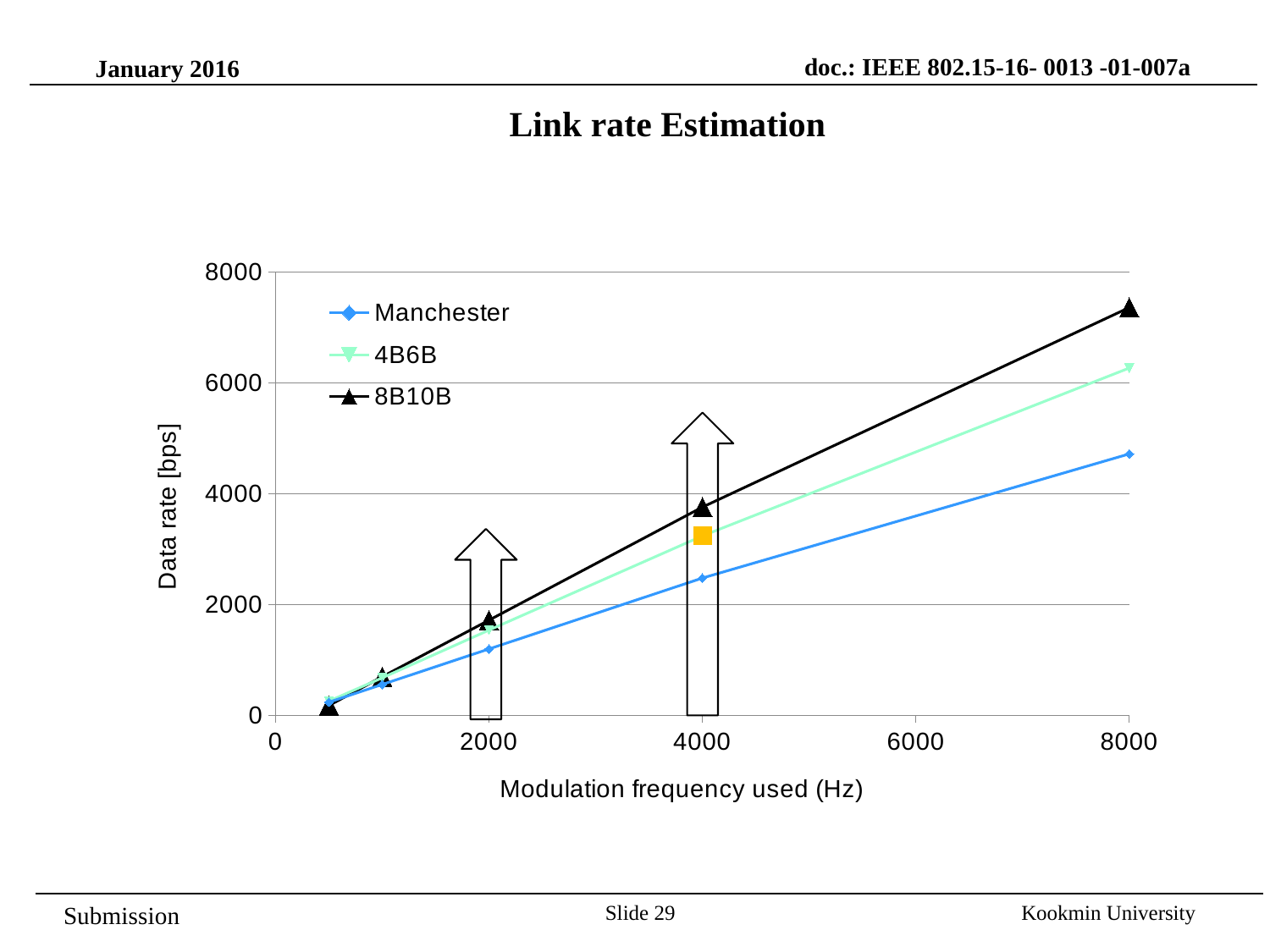
At 4000 Hz, which series has the larger data rate, Manchester or 8B10B? 8B10B Do the data rate values rise or fall as the modulation frequency increases? rise Is the 4B6B data rate at 4000 Hz greater or less than 4000 bps? less Is the Manchester data rate at 8000 Hz greater or less than 4000 bps? greater How many series does the legend list? 3 Is the Manchester data rate at 2000 Hz greater or less than 2000 bps? less Which series has the highest data rate at 8000 Hz? 8B10B What is the title of the chart? Link rate Estimation Which series has the lowest data rate at 8000 Hz? Manchester What are the three series named in the legend? Manchester, 4B6B, 8B10B What kind of chart is shown on the slide? line chart